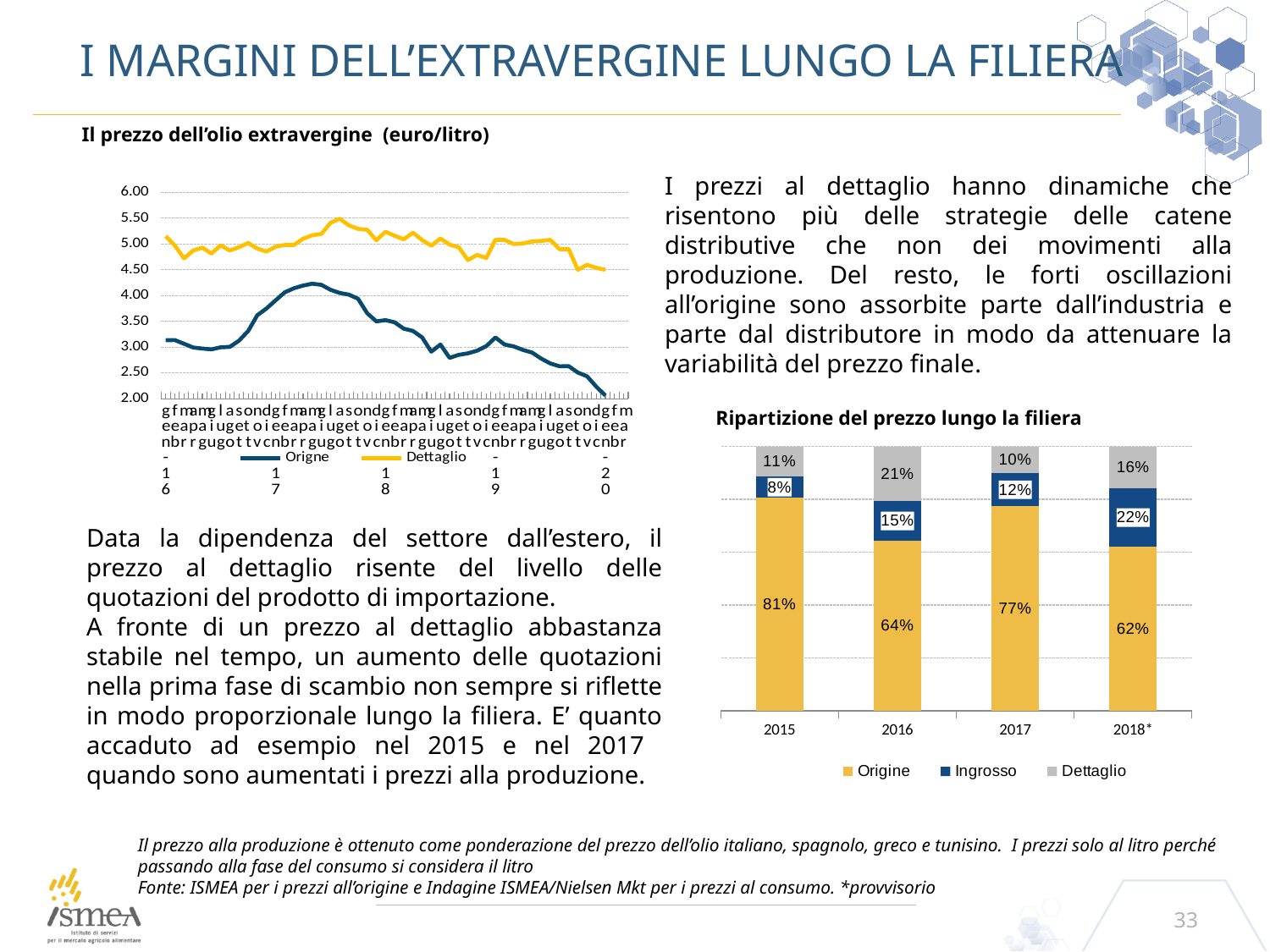
In the 'Ripartizione del prezzo lungo la filiera' chart, which year has the highest Dettaglio share? 2016 How many years are shown on the x axis of the 'Ripartizione del prezzo lungo la filiera' chart? 4 In the 'Ripartizione del prezzo lungo la filiera' chart, what is the Dettaglio share in 2016? 21% What kind of chart is 'Il prezzo dell'olio extravergine (euro/litro)'? Line chart In the 'Ripartizione del prezzo lungo la filiera' chart, what is the Ingrosso share in 2018*? 22% In the 'Il prezzo dell'olio extravergine (euro/litro)' chart, is the final value of the Origne series greater or less than 2.50? less In the 'Ripartizione del prezzo lungo la filiera' chart, is the Ingrosso share larger in 2017 or in 2018*? 2018* In the 'Il prezzo dell'olio extravergine (euro/litro)' chart, is the highest value of the Dettaglio series greater or less than 5.00? greater How many series does the legend of the 'Ripartizione del prezzo lungo la filiera' chart list? 3 In the 'Ripartizione del prezzo lungo la filiera' chart, which year has the lowest Origine share? 2018* In the 'Ripartizione del prezzo lungo la filiera' chart, what is the Origine share in 2015? 81% In the 'Ripartizione del prezzo lungo la filiera' chart, what is the difference between the Origine share in 2015 and in 2016? 17%